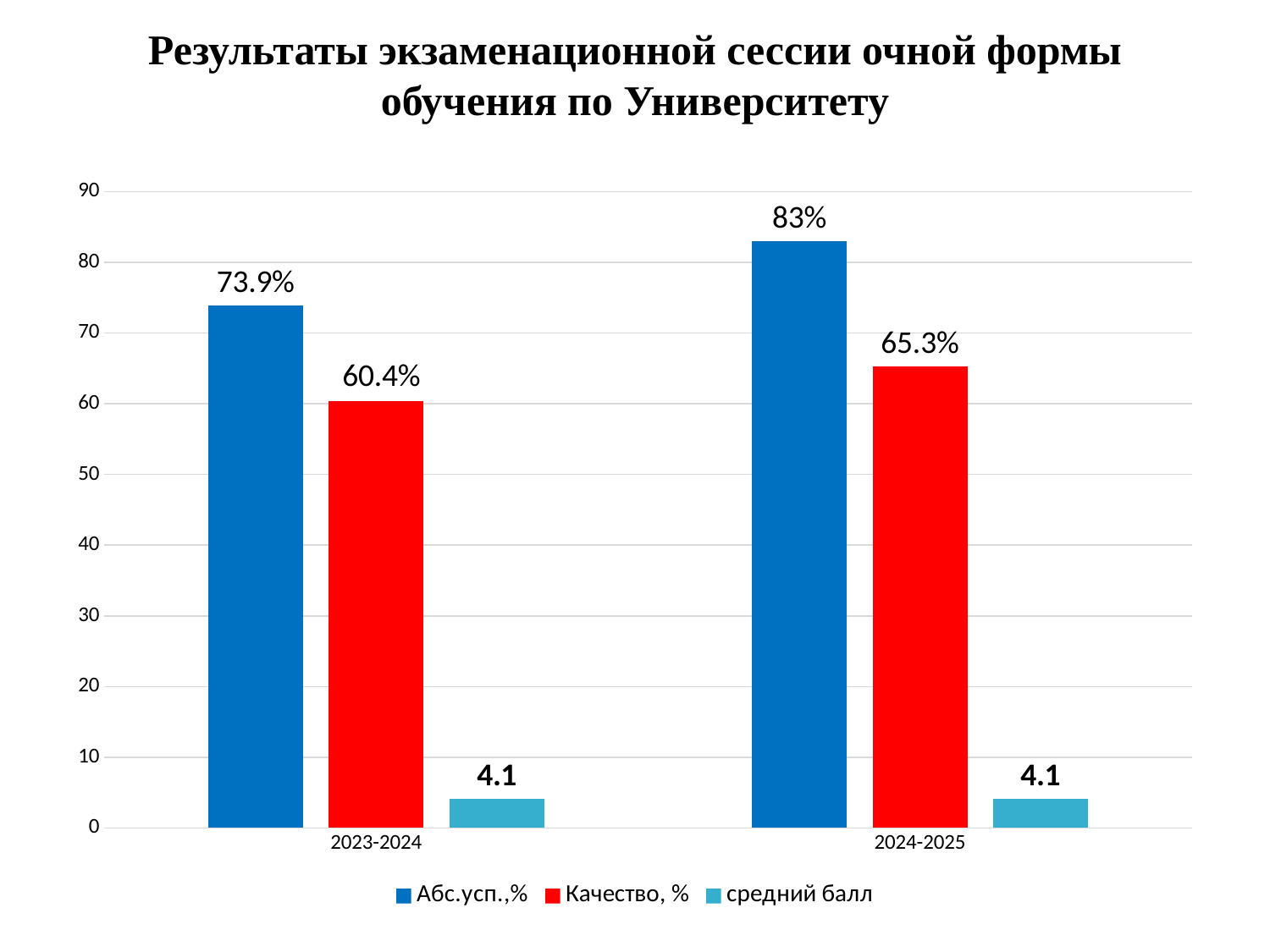
What is the value of Абс.усп.,% for 2024-2025? 83% What is the value of Качество, % for 2024-2025? 65.3% What is the value of средний балл for 2023-2024? 4.1 By how many percentage points did Качество, % change from 2023-2024 to 2024-2025? 4.9 Which series has the lowest value in 2024-2025? средний балл How many series does the legend list? 3 Which year has the higher Абс.усп.,% value? 2024-2025 Is the Качество, % value for 2023-2024 larger or smaller than the Качество, % value for 2024-2025? smaller Is the Абс.усп.,% value for 2024-2025 greater or less than 80? greater What is the value of Абс.усп.,% for 2023-2024? 73.9% How many categories are shown on the x axis? 2 What kind of chart is shown on the slide? bar chart